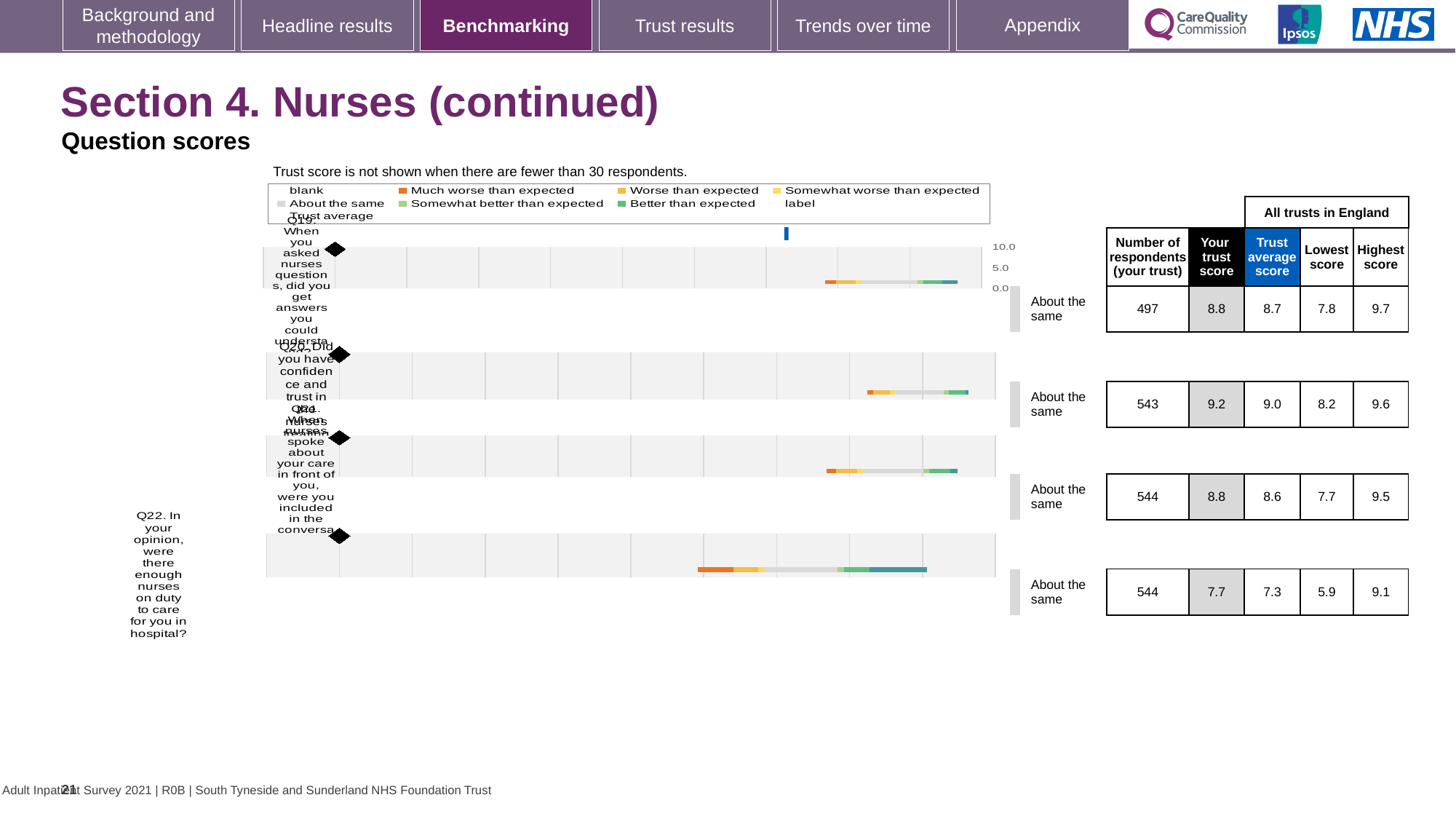
What kind of chart is used to show the question scores? bar chart In the table beside the chart, what is the 'Your trust score' for Q22? 7.7 In the table beside the chart, what is the 'Lowest score' for Q22? 5.9 In the table beside the chart, what is the difference between the 'Your trust score' and the 'Trust average score' for Q19? 0.1 In the table beside the chart, which is larger for Q21: the 'Your trust score' or the 'Trust average score'? Your trust score In the table beside the chart, which question has the highest 'Your trust score'? Q20 What benchmark category label is shown next to each of the four question bars? About the same In the table beside the chart, which question has the lowest 'Your trust score'? Q22 In the table beside the chart, what is the difference between the 'Highest score' and the 'Lowest score' for Q22? 3.2 What is the highest value shown on the chart's score axis? 10.0 How many survey questions are plotted as bars in the chart? 4 In the table beside the chart, how many respondents are listed for Q20? 543